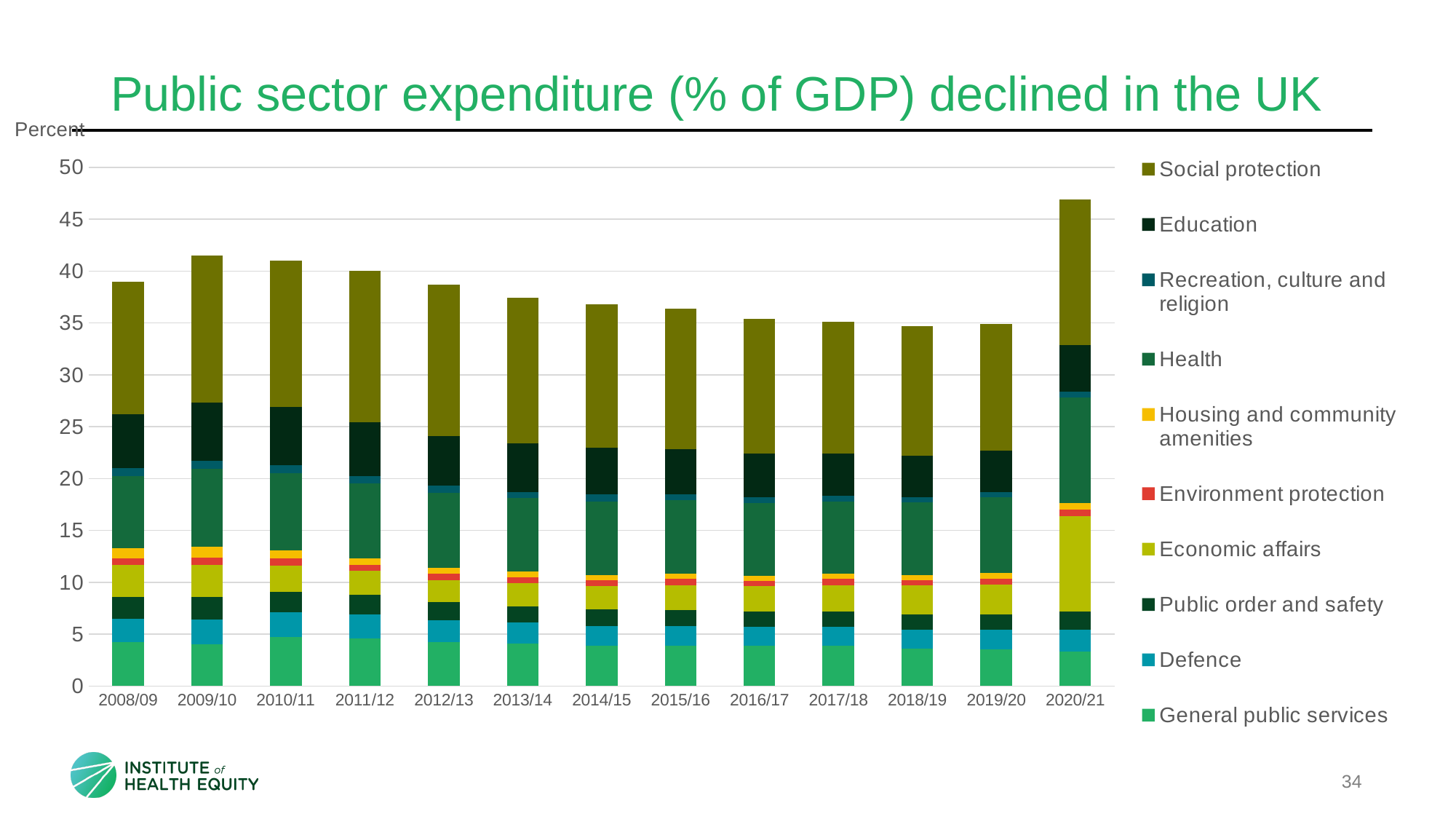
How many series does the legend list? 10 Is the total bar for 2012/13 greater or less than 40? less Which year has the larger total bar, 2009/10 or 2019/20? 2009/10 Is the total bar for 2020/21 greater or less than 45? greater What kind of chart is shown on the slide? Stacked bar chart Which year has the highest total public sector expenditure as a share of GDP? 2020/21 Is the total bar for 2009/10 greater or less than 40? greater Do the total bars generally rise or fall from 2009/10 to 2018/19? fall What is the title of the chart? Public sector expenditure (% of GDP) declined in the UK How many fiscal years (bars) are shown on the x axis? 13 Which series is listed first (at the top) in the legend? Social protection